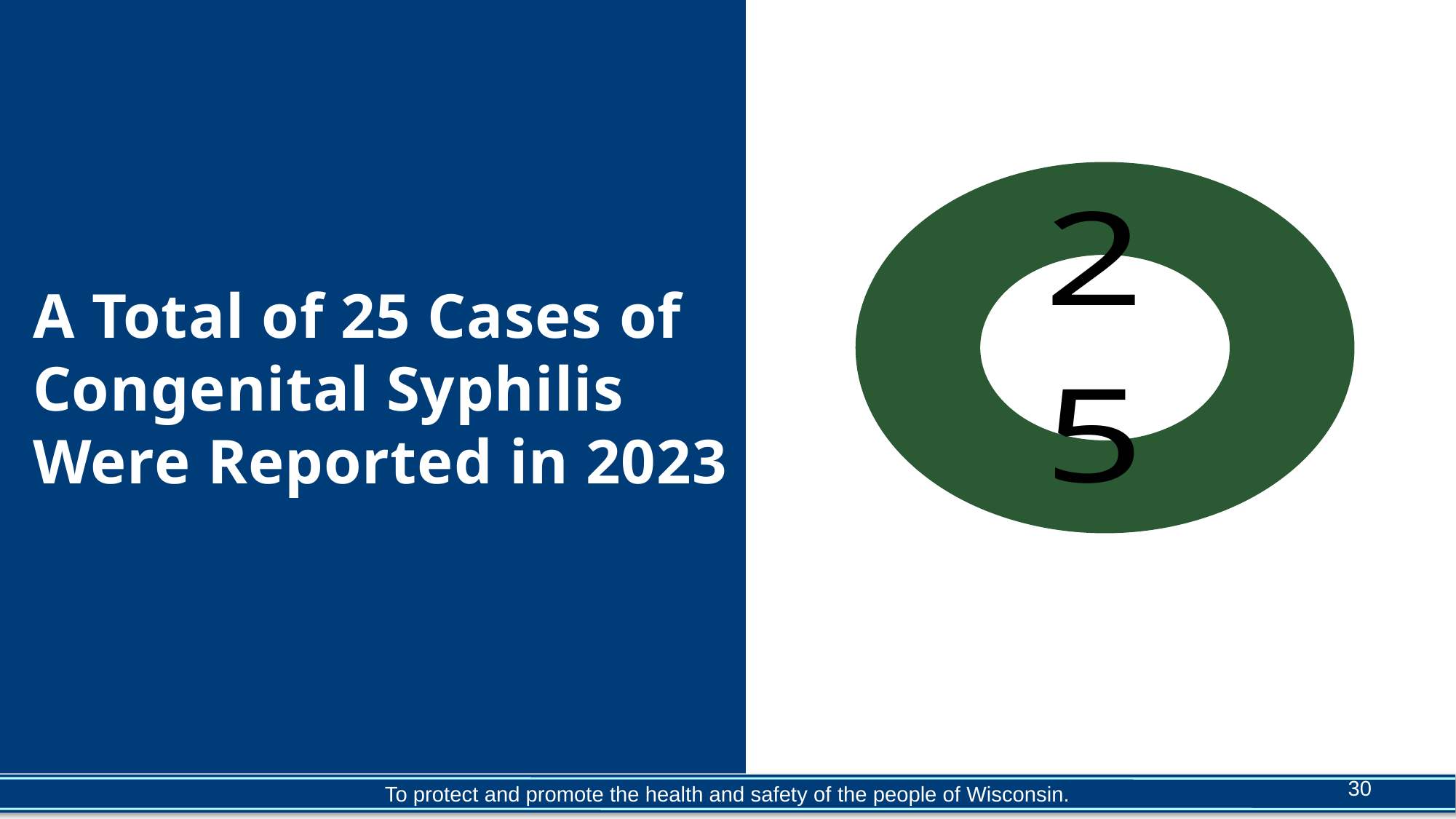
What colour is the ring of the doughnut chart? green Which year does the slide's title say the 25 congenital syphilis cases were reported in? 2023 How many distinct coloured segments are visible in the doughnut chart? 1 According to the slide, how many cases of congenital syphilis were reported in 2023? 25 What number is displayed in the centre of the doughnut chart? 25 What kind of chart is shown on the right side of the slide? doughnut chart